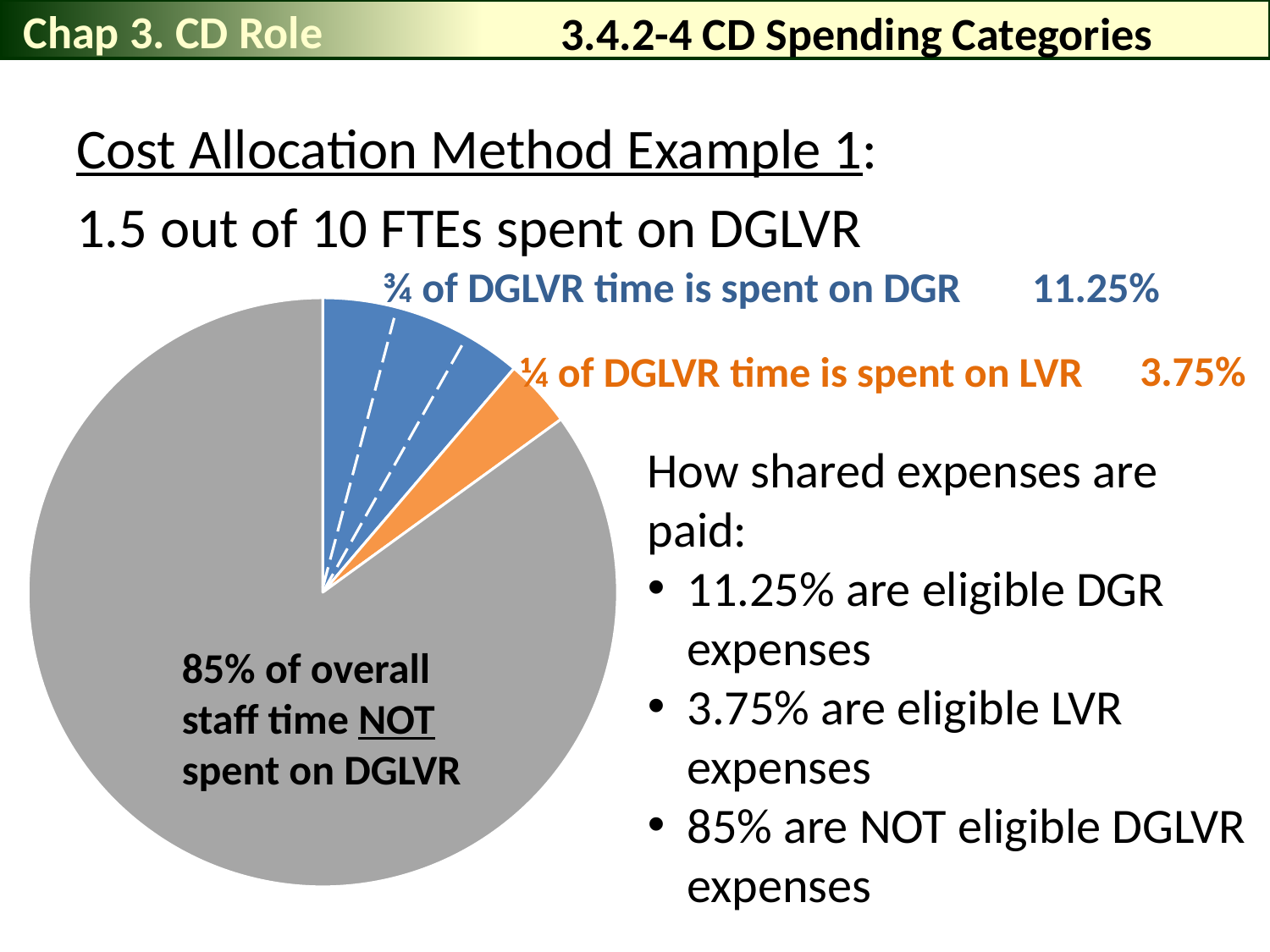
What colour is the slice representing time spent on DGR? blue How many slices does the pie chart have? 3 What percentage of time is spent on LVR according to the pie chart? 3.75% What percentage of time is spent on DGR according to the pie chart? 11.25% What kind of chart is shown on the slide? pie chart What is the difference between the DGR share and the LVR share in the pie chart? 7.5% What colour is the slice representing time spent on LVR? orange Which slice of the pie chart is the smallest? LVR (3.75%) Which slice of the pie chart is the largest? 85% of overall staff time NOT spent on DGLVR What is the combined share of the DGR and LVR slices in the pie chart? 15% What share of overall staff time is NOT spent on DGLVR according to the pie chart? 85% Which is larger in the pie chart, the DGR slice or the LVR slice? DGR